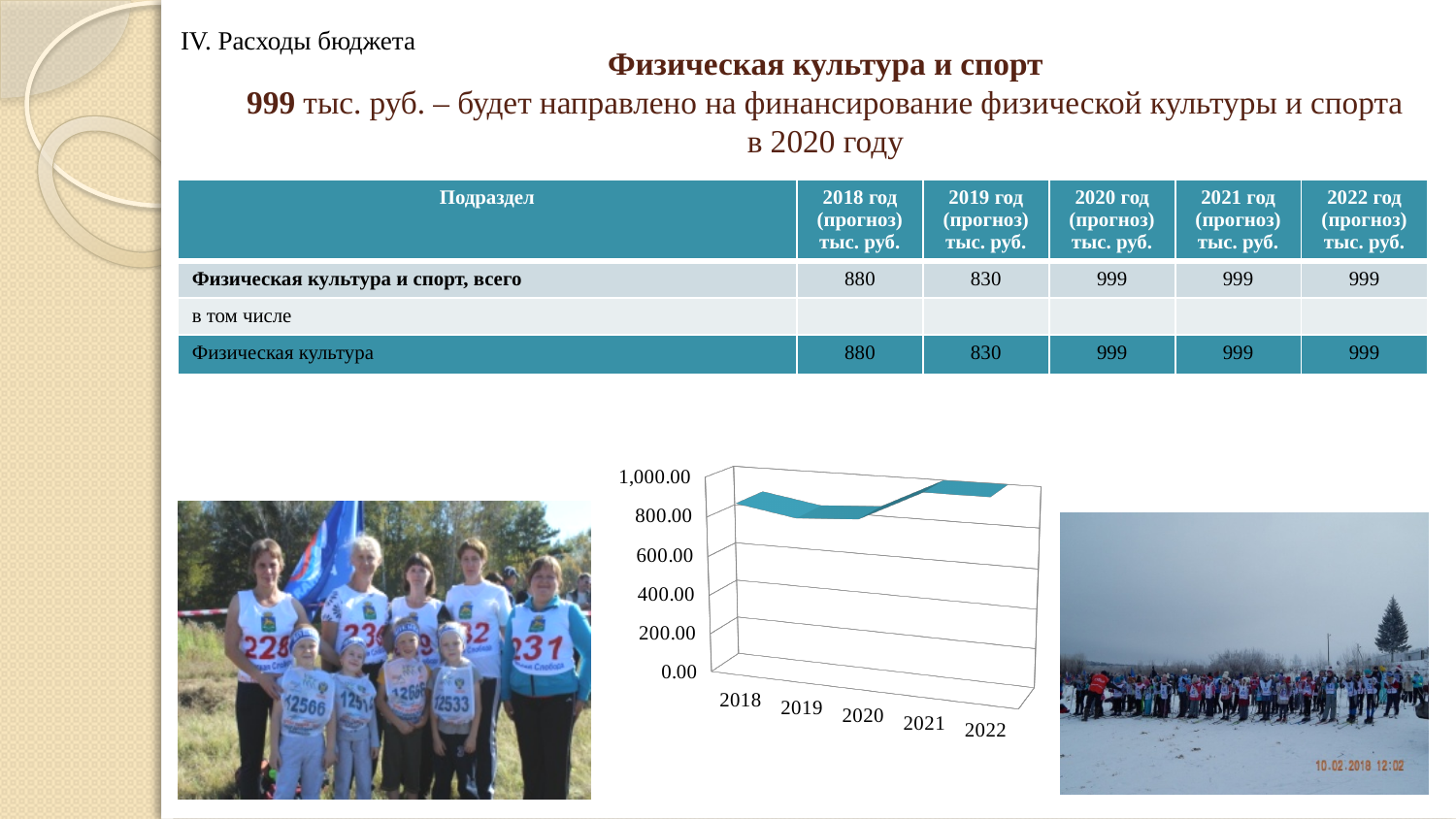
Is the value for 2019 on the chart greater or less than 1,000.00? less Which is larger on the chart, the value for 2018 or the value for 2019? 2018 Is the value for 2022 on the chart greater or less than 600.00? greater Is the value for 2018 on the chart greater or less than 800.00? greater How many years are plotted along the x axis of the chart? 5 What is the highest tick label on the vertical axis of the chart? 1,000.00 What kind of chart is shown on the slide? line chart Does the value on the chart rise or fall from 2018 to 2019? fall